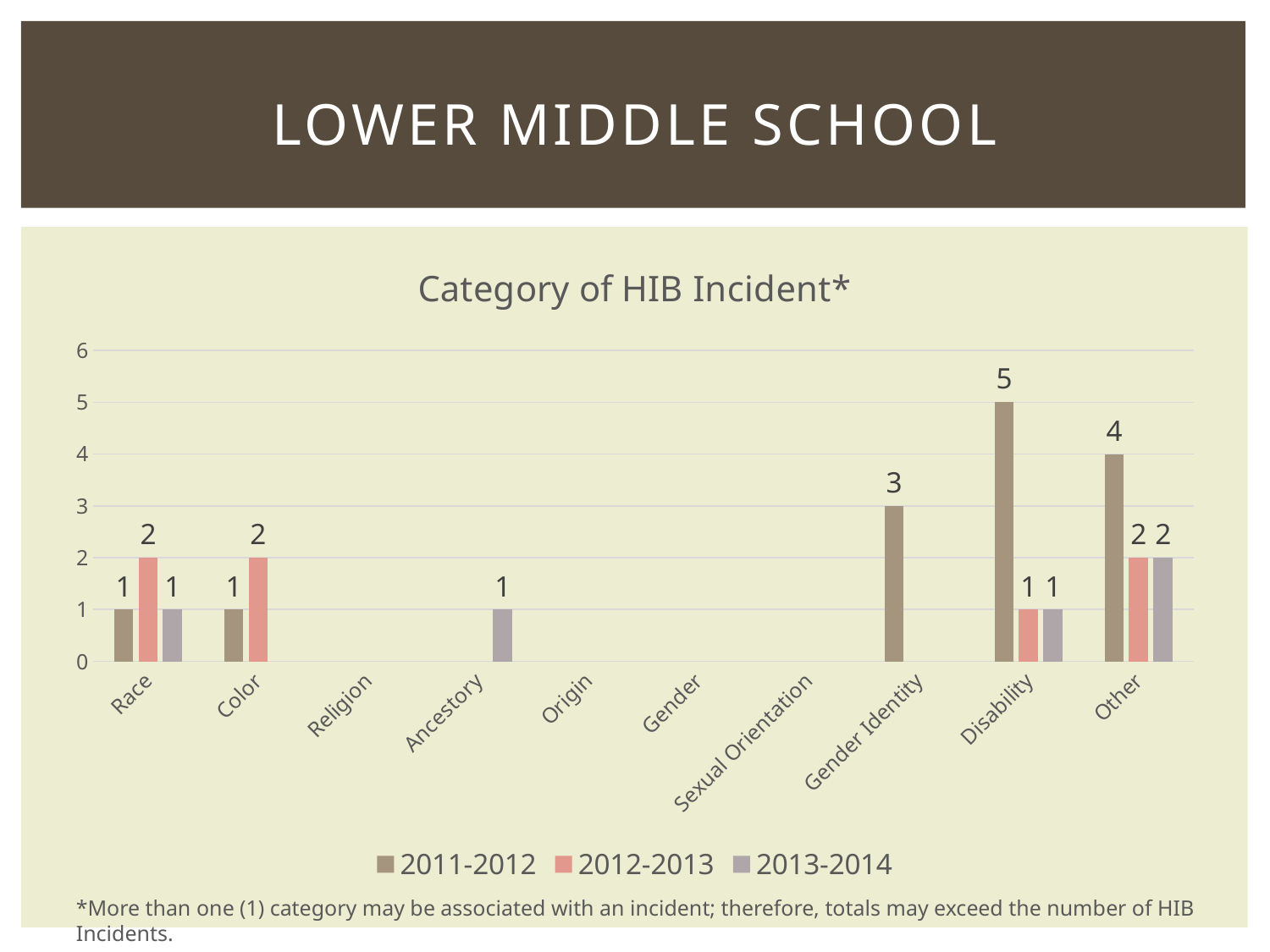
What is the title of the chart? Category of HIB Incident* What is the value for Ancestry in the 2013-2014 series? 1 What is the value for Disability in the 2011-2012 series? 5 Which is larger: the 2012-2013 value for Race or the 2012-2013 value for Disability? Race Which category has the highest value in the 2011-2012 series? Disability What is the value for Other in the 2012-2013 series? 2 Which series is shown in red/pink in the legend? 2012-2013 What is the value for Gender Identity in the 2011-2012 series? 3 How many categories are shown on the x axis? 10 How many series does the legend list? 3 What is the difference between the 2011-2012 values for Disability and Other? 1 What kind of chart is shown on the slide? Bar chart